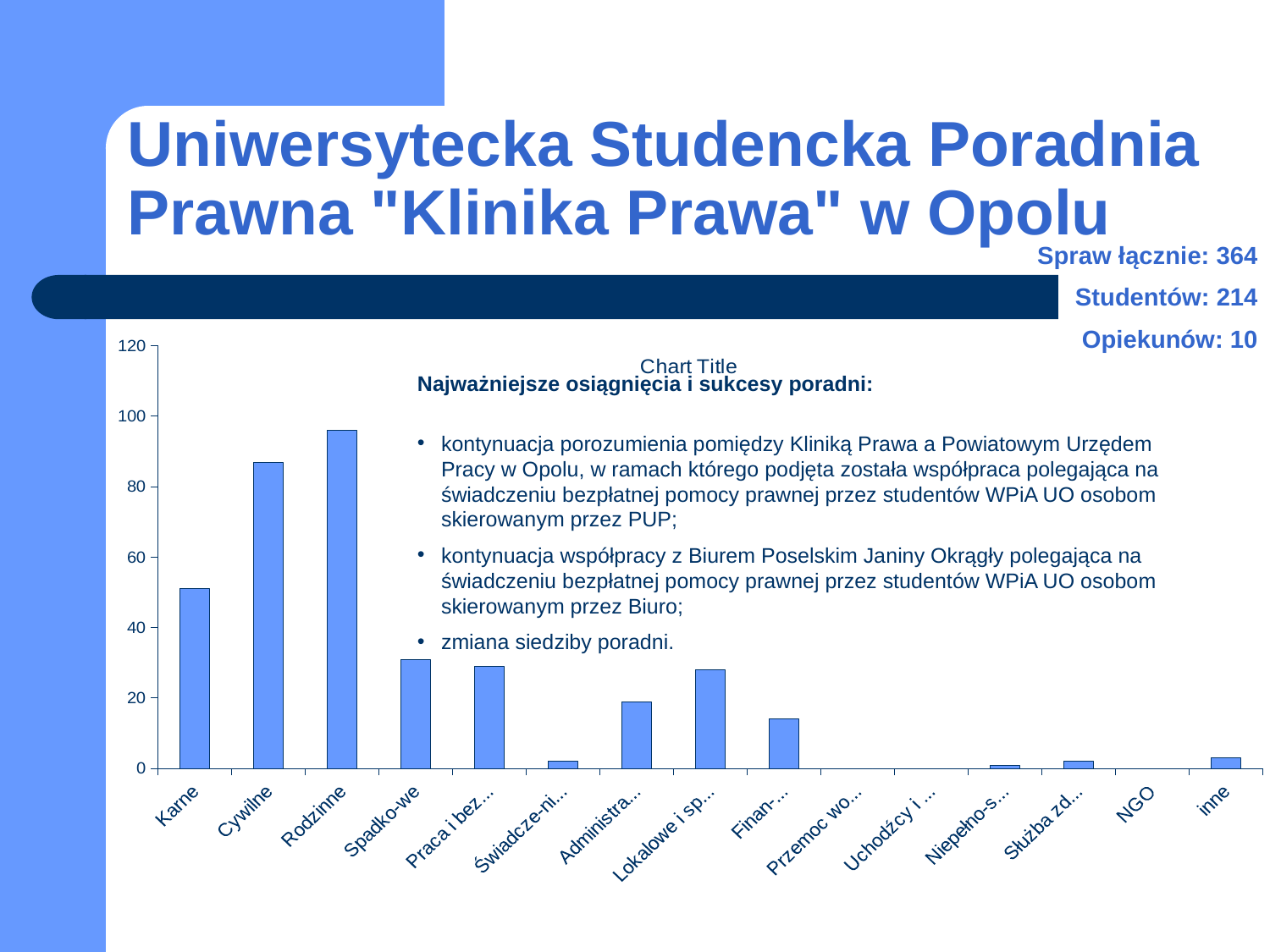
Which category has the highest value in the chart? Rodzinne What kind of chart is shown on the slide? bar chart Is the value for Rodzinne greater or less than 100? less Is the value for Finan-... greater or less than 20? less Is the value for Cywilne greater or less than 80? greater Which is larger, the value for Rodzinne or the value for Spadko-we? Rodzinne How many categories are shown on the x axis of the chart? 15 Which is larger, the value for Cywilne or the value for Karne? Cywilne What is the title shown on the chart? Chart Title What is the highest value shown on the vertical axis of the chart? 120